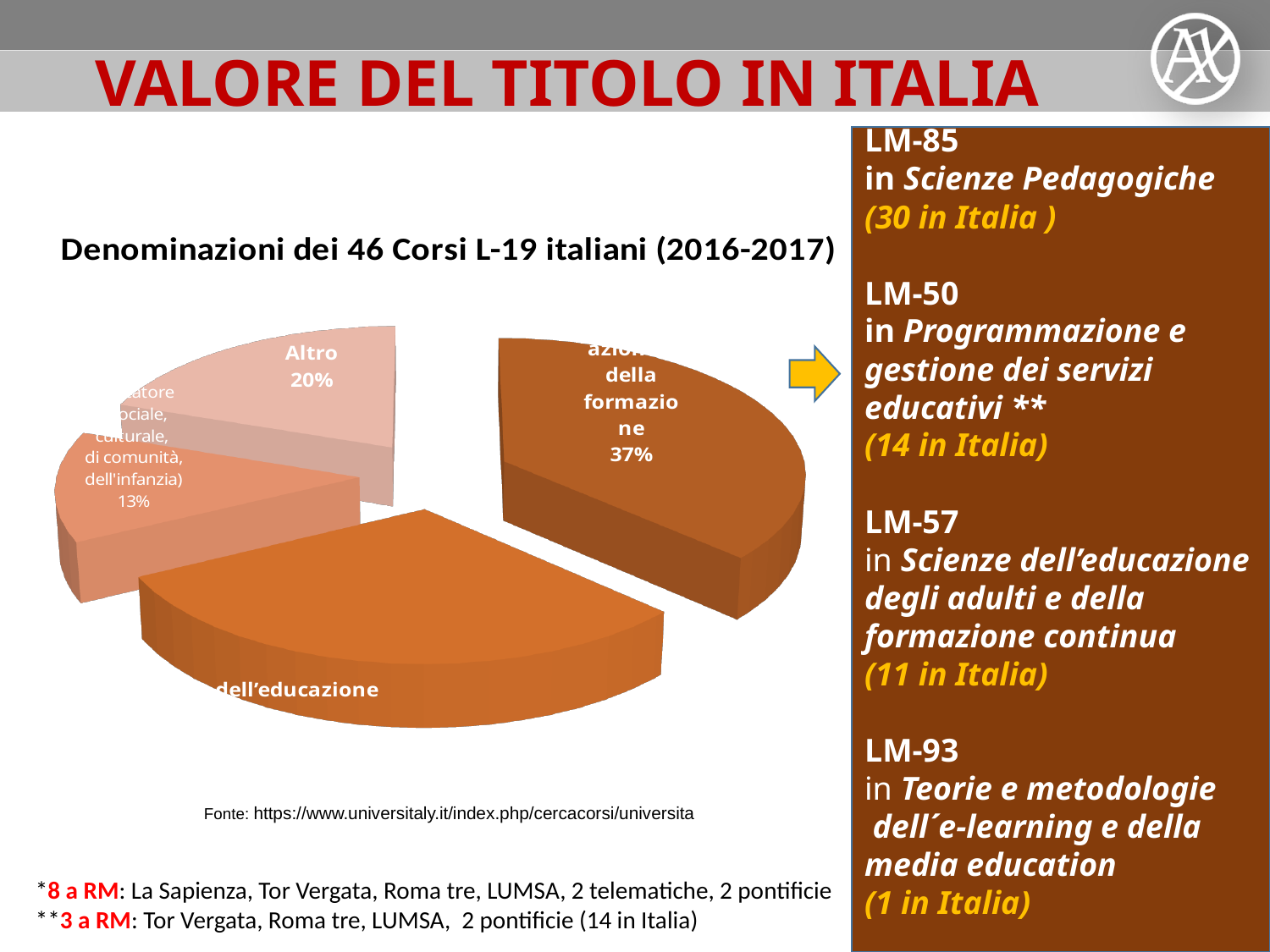
What is the title of the pie chart? Denominazioni dei 46 Corsi L-19 italiani (2016-2017) What is the difference in percentage points between the '...della formazione' slice (37%) and the 'Altro' slice (20%)? 17 percentage points What is the smallest percentage printed on the pie chart? 13% What is the difference in percentage points between the 'Altro' slice (20%) and the slice labelled 13%? 7 percentage points What percentage of the pie does the 'Altro' slice represent? 20% Which slice is larger: 'Altro' or the slice labelled '...della formazione'? ...della formazione How many slices does the pie chart have? 4 What percentage is shown for the slice labelled '...della formazione'? 37% Is the share of the 'Altro' slice greater or less than 25%? less Is the share of the '...della formazione' slice greater or less than 30%? greater What source is cited below the pie chart? https://www.universitaly.it/index.php/cercacorsi/universita What kind of chart is shown on the slide? Pie chart